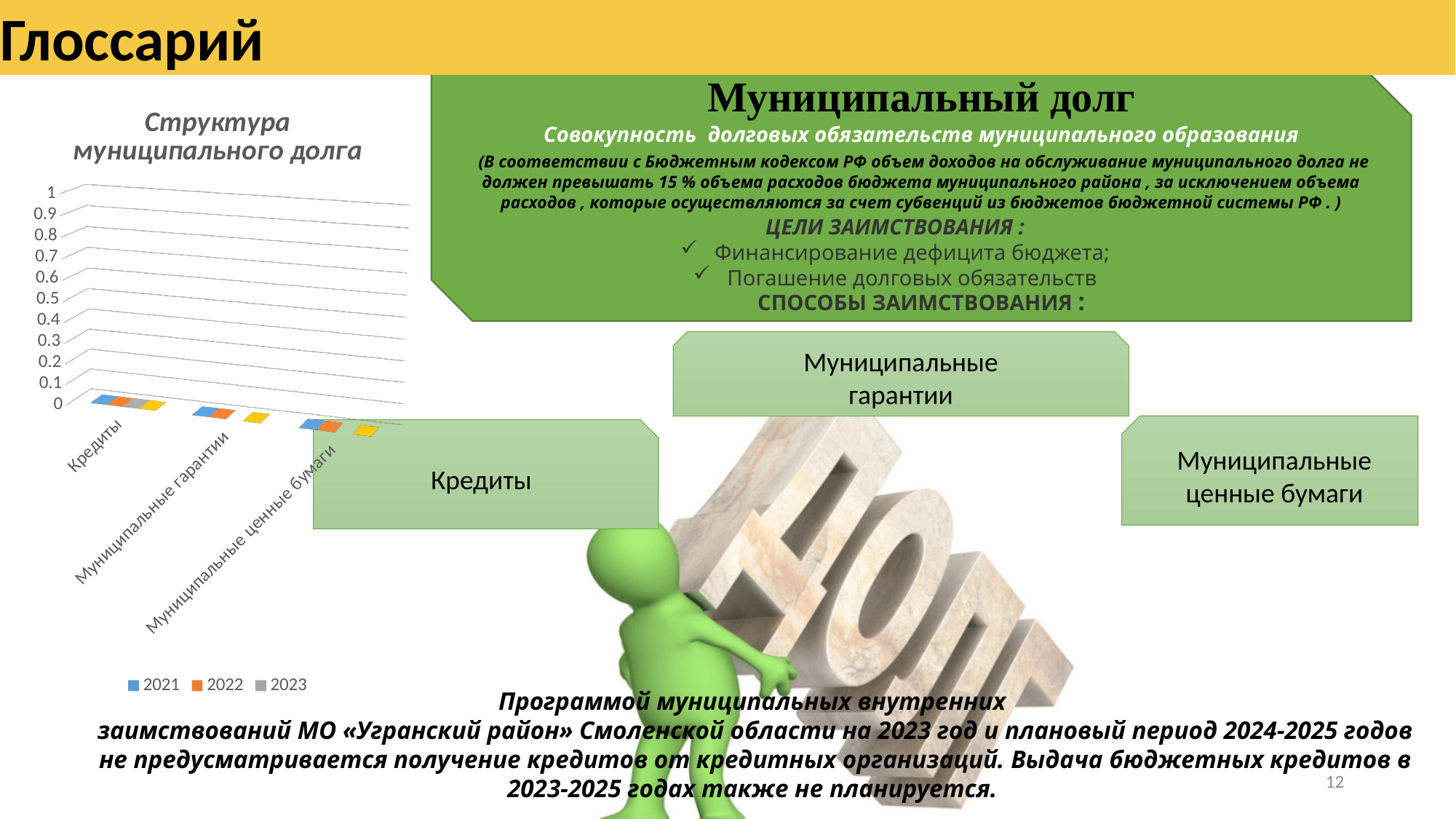
What is the highest tick value shown on the vertical axis of the "Структура муниципального долга" chart? 1 What kind of chart is "Структура муниципального долга"? bar chart Which years are listed in the legend of the "Структура муниципального долга" chart? 2021, 2022, 2023 How many series does the legend of the "Структура муниципального долга" chart list? 3 What is the title of the chart on the left of the slide? Структура муниципального долга How many categories are shown on the x axis of the "Структура муниципального долга" chart? 3 In the "Структура муниципального долга" chart, is the value for Муниципальные гарантии in 2022 greater or less than 0.5? less In the "Структура муниципального долга" chart, is the value for Кредиты in 2021 greater or less than 0.5? less